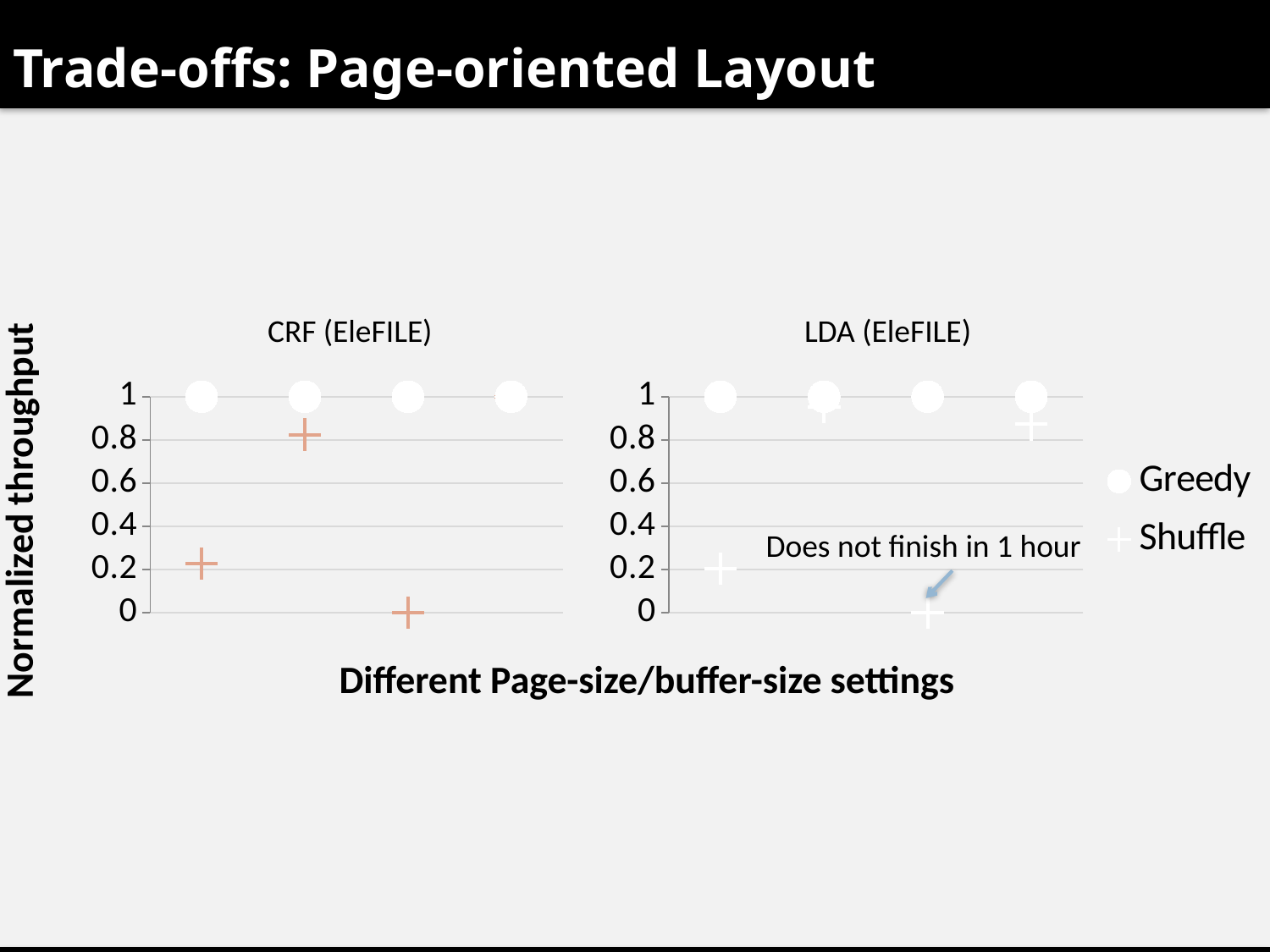
In the CRF (EleFILE) chart, what is the normalized throughput of the Greedy points? 1 In the CRF (EleFILE) chart, which series has the higher value at the second setting, Greedy or Shuffle? Greedy In the CRF (EleFILE) chart, is the second Shuffle point greater or less than 0.6? greater How many series does the legend list? 2 In the CRF (EleFILE) chart, is the first Shuffle point greater or less than 0.4? less What are the two series named in the legend? Greedy and Shuffle In the LDA (EleFILE) chart, what annotation is attached to the Shuffle point at the third setting? Does not finish in 1 hour In the LDA (EleFILE) chart, is the fourth Shuffle point greater or less than 0.6? greater In the LDA (EleFILE) chart, what is the normalized throughput of the Shuffle point at the third setting? 0 What kind of chart is the CRF (EleFILE) chart? scatter chart In the CRF (EleFILE) chart, how many Greedy points are plotted? 4 In the LDA (EleFILE) chart, do the Greedy values rise, fall, or stay constant across the settings? stay constant